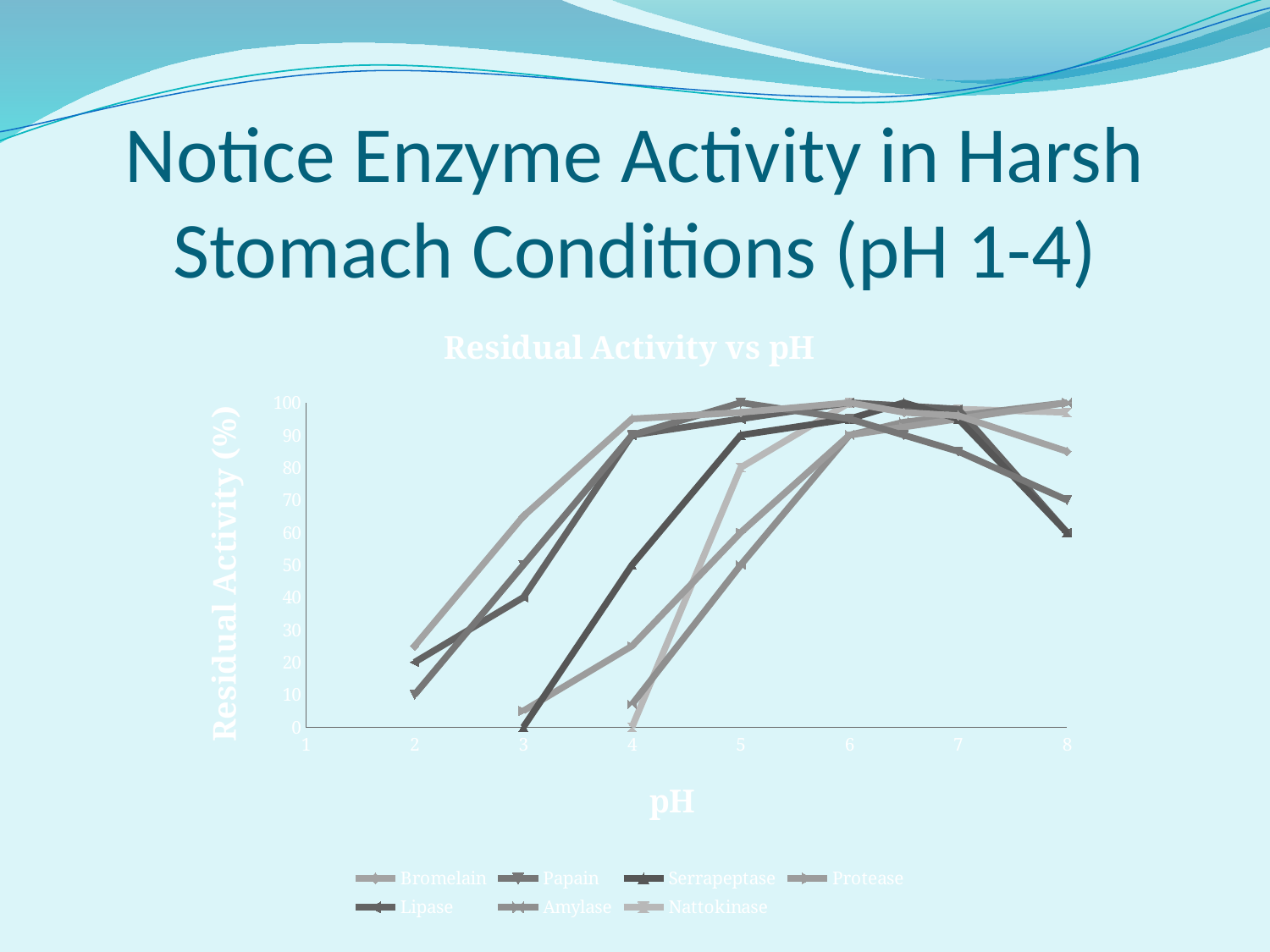
At pH 8, are all the plotted values greater or less than 50? greater How many series does the legend of the chart list? 7 How many pH values are marked along the x axis of the chart? 8 What is the title of the chart? Residual Activity vs pH At pH 2, are all the plotted values greater or less than 30? less Between pH 2 and pH 5, do the plotted lines generally rise or fall? rise What kind of chart is shown on the slide? line chart What is the label of the vertical axis of the chart? Residual Activity (%)